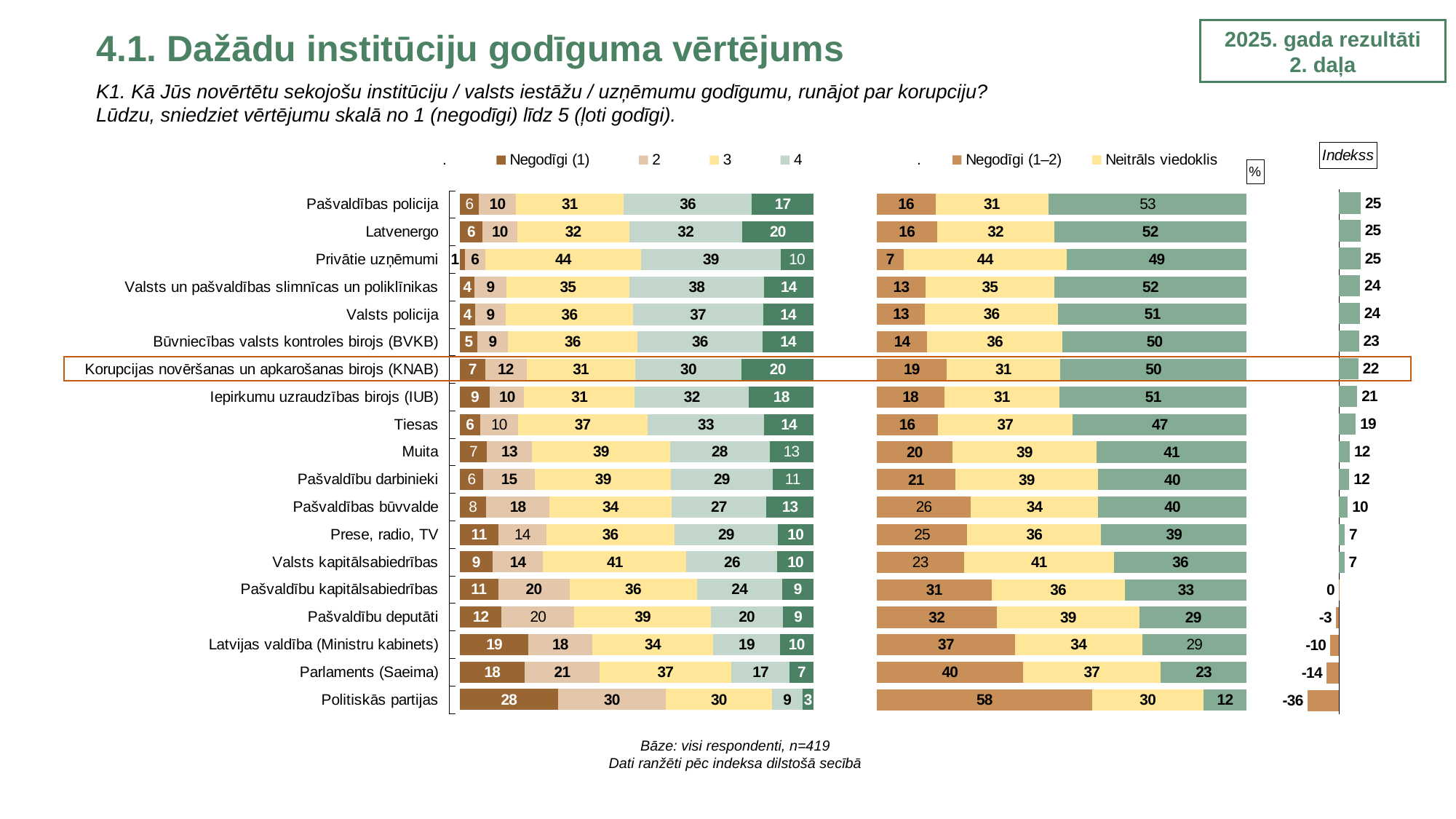
What kind of chart is the left chart on the slide? Stacked bar chart In the middle stacked bar chart, which has the larger Negodīgi (1–2) value: Parlaments (Saeima) or Latvijas valdība (Ministru kabinets)? Parlaments (Saeima) In the left stacked bar chart, what is the Negodīgi (1) value for Parlaments (Saeima)? 18 In the middle stacked bar chart, what is the Negodīgi (1–2) value for Politiskās partijas? 58 In the Indekss chart on the right, what is the index value for Pašvaldību kapitālsabiedrības? 0 In the Indekss chart on the right, what is the index value for Korupcijas novēršanas un apkarošanas birojs (KNAB)? 22 In the Indekss chart on the right, what is the difference between the index values for Tiesas and Muita? 7 In the Indekss chart on the right, what is the index value for Politiskās partijas? -36 In the Indekss chart on the right, which institution has the lowest index value? Politiskās partijas In the left stacked bar chart, what is the value of the '4' segment for Privātie uzņēmumi? 39 In the middle stacked bar chart, what is the Neitrāls viedoklis value for Muita? 39 How many institutions are listed in the left stacked bar chart? 19